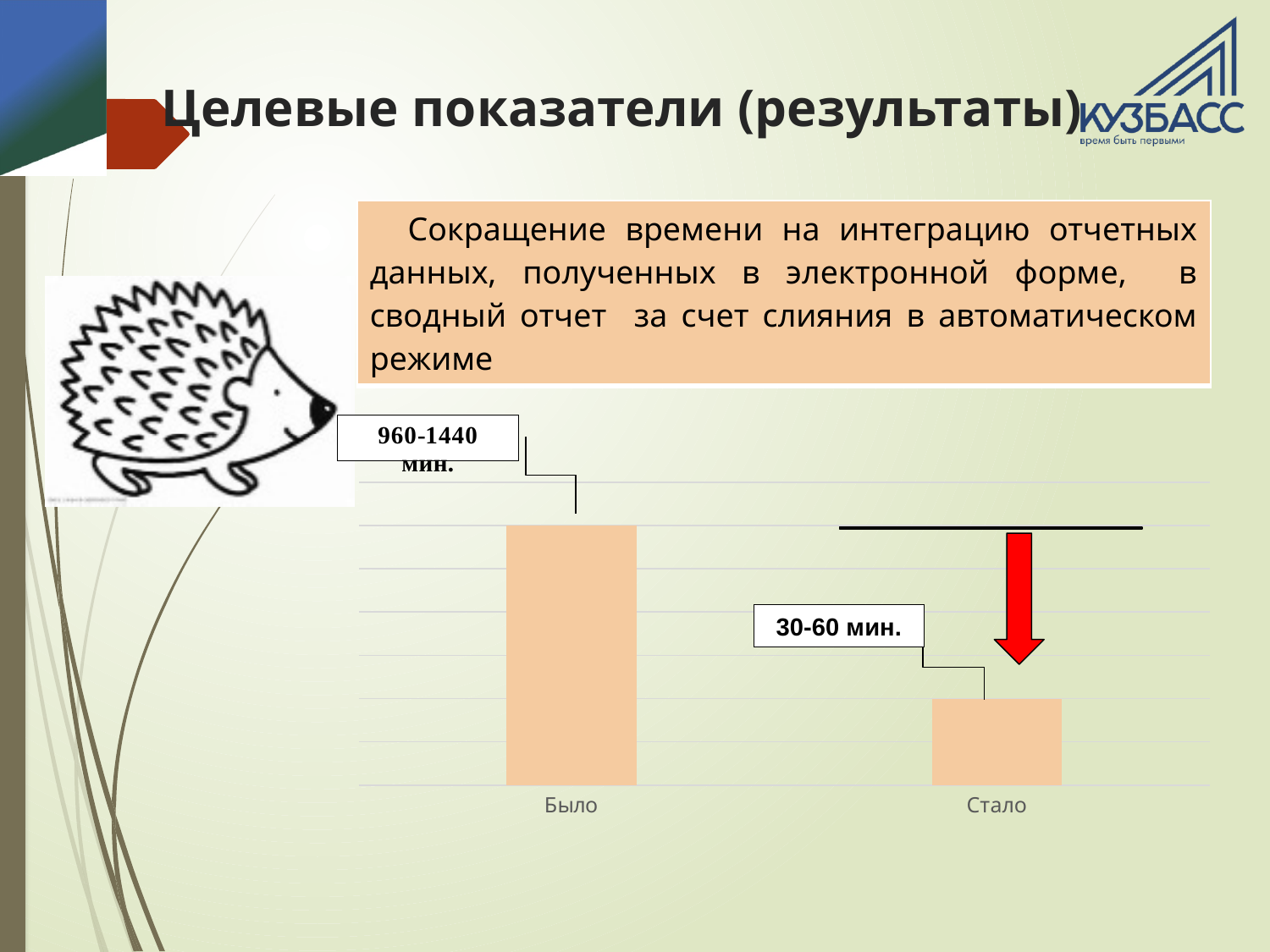
In which direction does the red arrow next to the "Стало" bar point? Down What value is labelled for the "Стало" bar? 30-60 мин. Which category has the tallest bar? Было Do the bar values rise or fall from "Было" to "Стало"? Fall Which bar is taller, "Было" or "Стало"? Было How many categories are shown on the x axis of the chart? 2 What are the category labels on the x axis of the chart? Было, Стало What value is labelled for the "Было" bar? 960-1440 мин. What kind of chart is shown on the slide? Bar chart Which category has the shortest bar? Стало